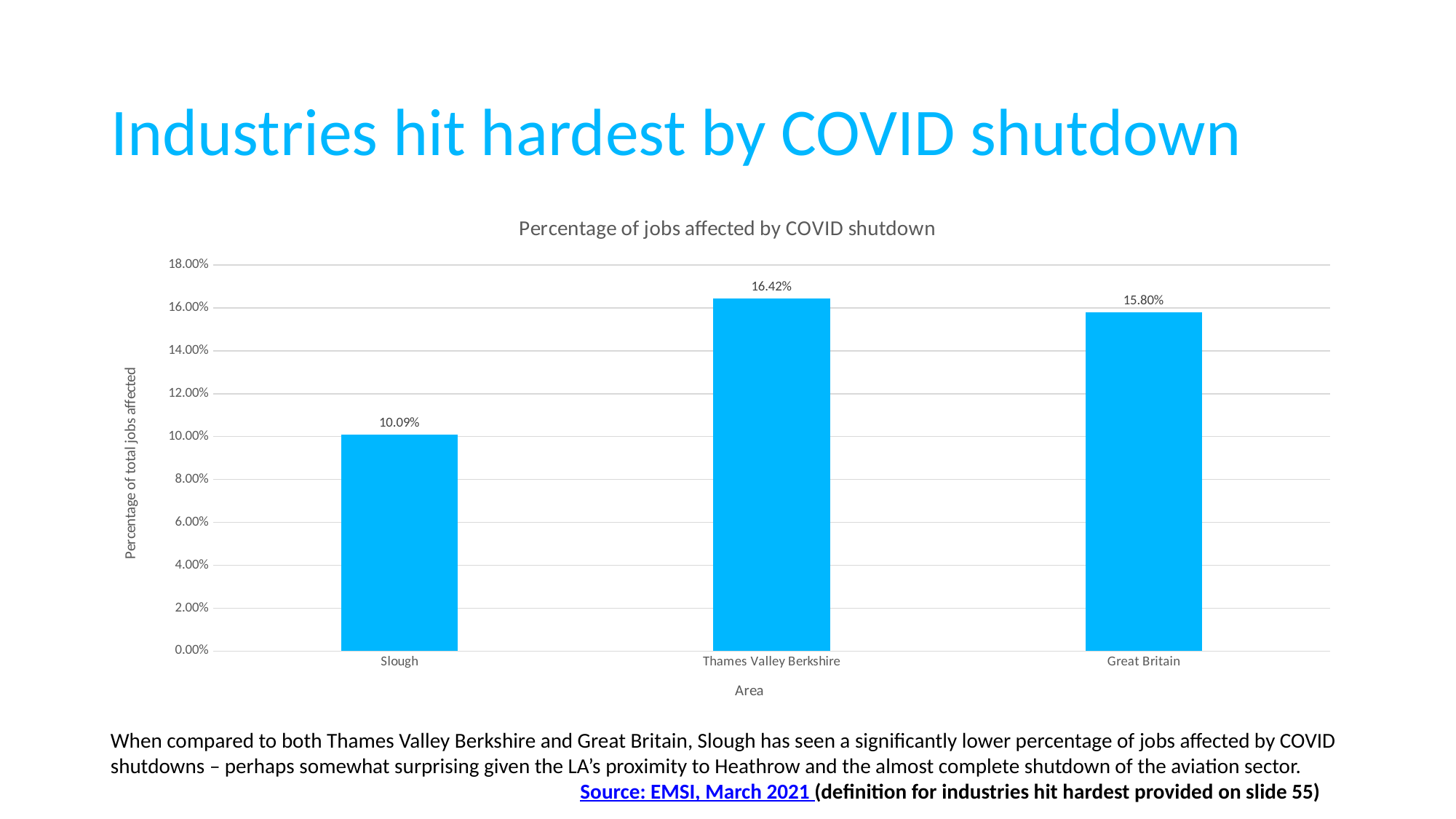
What is the difference between the values for Great Britain and Slough? 5.71% How many areas are shown on the chart? 3 Which has a higher percentage of jobs affected: Great Britain or Slough? Great Britain What percentage of jobs were affected by the COVID shutdown in Great Britain? 15.80% Which area has the highest percentage of jobs affected by the COVID shutdown? Thames Valley Berkshire Is the value for Slough greater or less than 12.00%? less What is the difference between the values for Thames Valley Berkshire and Slough? 6.33% What is the value shown for Thames Valley Berkshire? 16.42% What is the title of the chart? Percentage of jobs affected by COVID shutdown Which area has the lowest percentage of jobs affected by the COVID shutdown? Slough What type of chart is shown on the slide? Bar chart What percentage of jobs were affected by the COVID shutdown in Slough? 10.09%